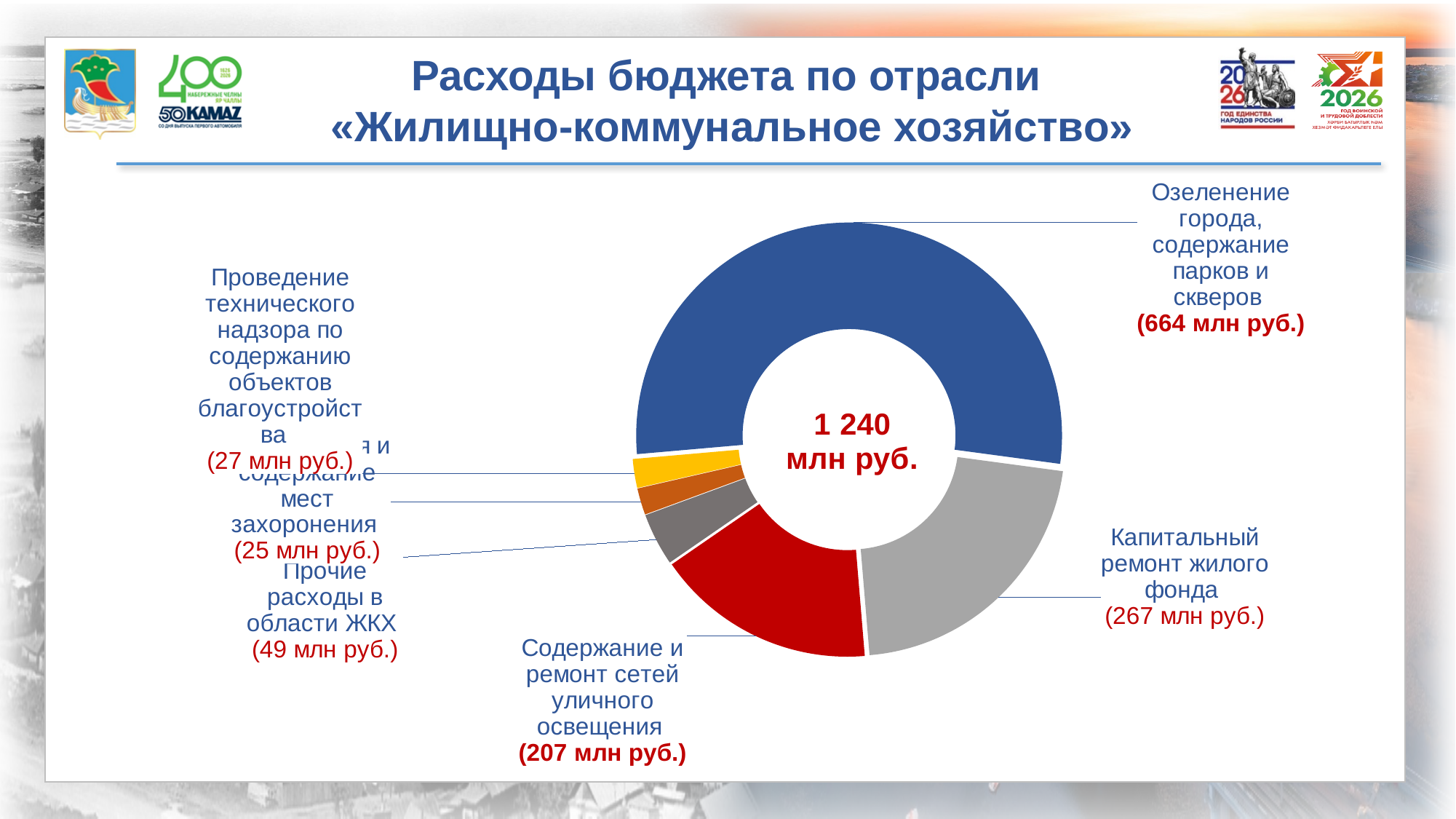
What is the value for «Прочие расходы в области ЖКХ»? 49 млн руб. What total amount is shown in the centre of the donut chart? 1 240 млн руб. How many categories (slices) does the chart have? 6 Which category has the smallest value on the chart? Содержание мест захоронения (25 млн руб.) What is the difference between «Капитальный ремонт жилого фонда» and «Содержание и ремонт сетей уличного освещения»? 60 млн руб. What is the value for «Содержание и ремонт сетей уличного освещения»? 207 млн руб. Which is larger: «Прочие расходы в области ЖКХ» or «Проведение технического надзора по содержанию объектов благоустройства»? Прочие расходы в области ЖКХ Which category has the largest share of the chart? Озеленение города, содержание парков и скверов What is the value for «Проведение технического надзора по содержанию объектов благоустройства»? 27 млн руб. What type of chart is shown on the slide? Pie (donut) chart What is the value for «Капитальный ремонт жилого фонда»? 267 млн руб. What is the value for «Озеленение города, содержание парков и скверов»? 664 млн руб.